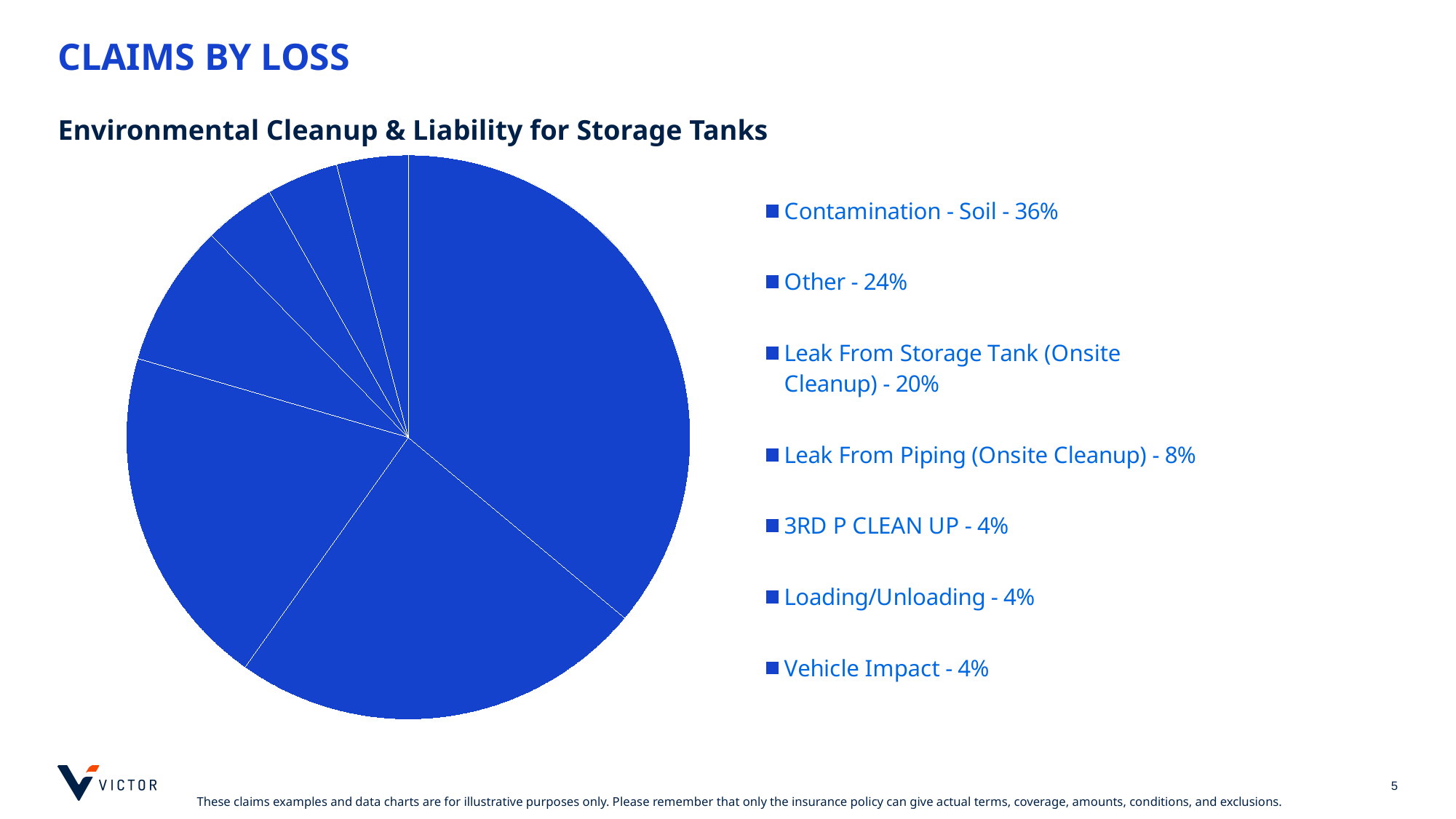
What share of claims is attributed to Contamination - Soil? 36% What is the difference in share between Contamination - Soil and Other? 12% What is the subtitle of the chart on the slide? Environmental Cleanup & Liability for Storage Tanks Which category has the largest share of claims? Contamination - Soil What share of claims is attributed to Other? 24% What is the difference in share between Leak From Piping (Onsite Cleanup) and Loading/Unloading? 4% What share of claims is attributed to Leak From Piping (Onsite Cleanup)? 8% What kind of chart is shown on the slide? Pie chart Which has a larger share, Other or Leak From Storage Tank (Onsite Cleanup)? Other How many categories does the legend list? 7